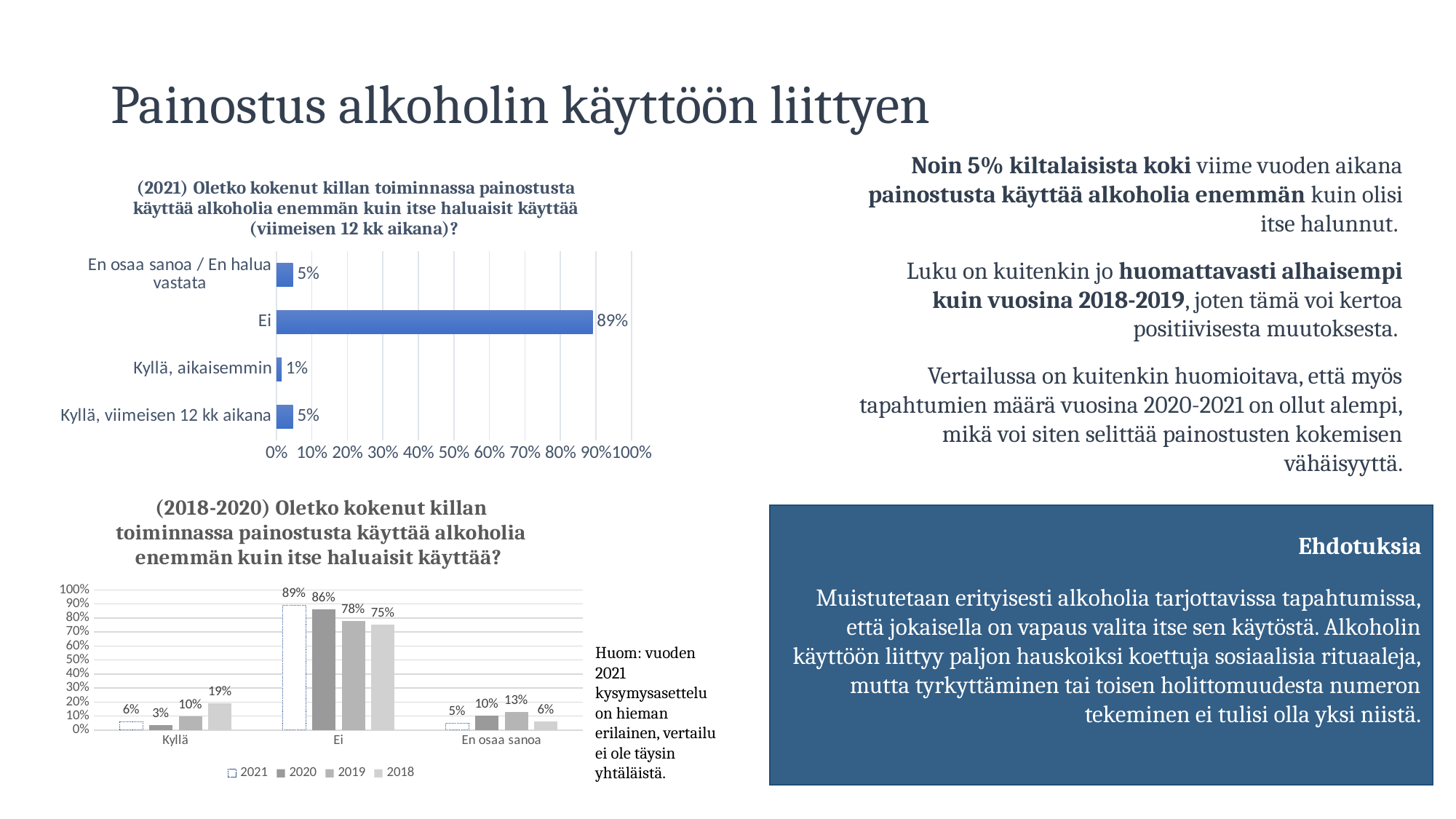
In the top chart (2021), which category has the lowest value? Kyllä, aikaisemmin In the bottom chart (2018-2020), which year has the highest value for "Kyllä"? 2018 In the top chart (2021), how many categories are shown? 4 In the top chart (2021), what is the value for "Kyllä, aikaisemmin"? 1% In the bottom chart (2018-2020), what is the value for "En osaa sanoa" in 2019? 13% In the bottom chart (2018-2020), what are the legend entries? 2021, 2020, 2019, 2018 In the top chart (2021), what is the value for "Ei"? 89% In the bottom chart (2018-2020), is the "Ei" value for 2020 larger or smaller than the "Ei" value for 2019? Larger What kind of chart is the top chart (2021)? Bar chart In the bottom chart (2018-2020), how many series does the legend list? 4 In the bottom chart (2018-2020), what is the value for "Kyllä" in 2018? 19% In the bottom chart (2018-2020), what is the difference between the "Ei" values for 2021 and 2018? 14%